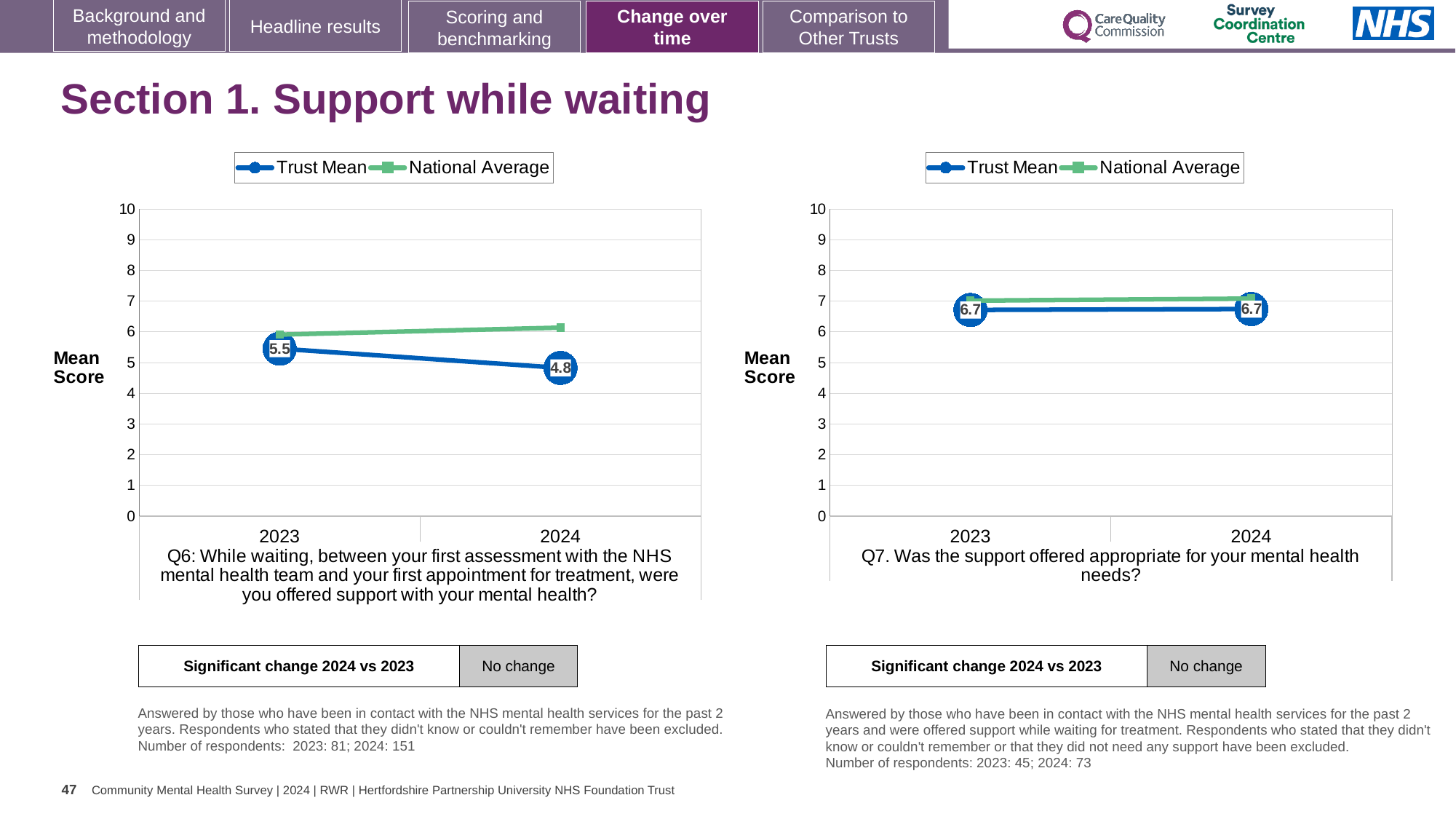
In the left chart (Q6), by how much did the Trust Mean fall from 2023 to 2024? 0.7 In the right chart (Q7), does the Trust Mean rise, fall or stay the same from 2023 to 2024? stay the same In the left chart (Q6), which is higher in 2024, the Trust Mean or the National Average? National Average What kind of chart is the left chart (Q6)? line chart In the left chart (Q6), what is the Trust Mean score for 2024? 4.8 How many years are shown on the x axis of the left chart (Q6)? 2 In the left chart (Q6), is the National Average for 2024 greater or less than 5? greater In the left chart (Q6), what is the Trust Mean score for 2023? 5.5 In the right chart (Q7), is the National Average for 2023 greater or less than 6? greater In the right chart (Q7), what is the Trust Mean score for 2024? 6.7 How many series does the legend of the right chart (Q7) list? 2 In the left chart (Q6), does the Trust Mean rise or fall from 2023 to 2024? fall